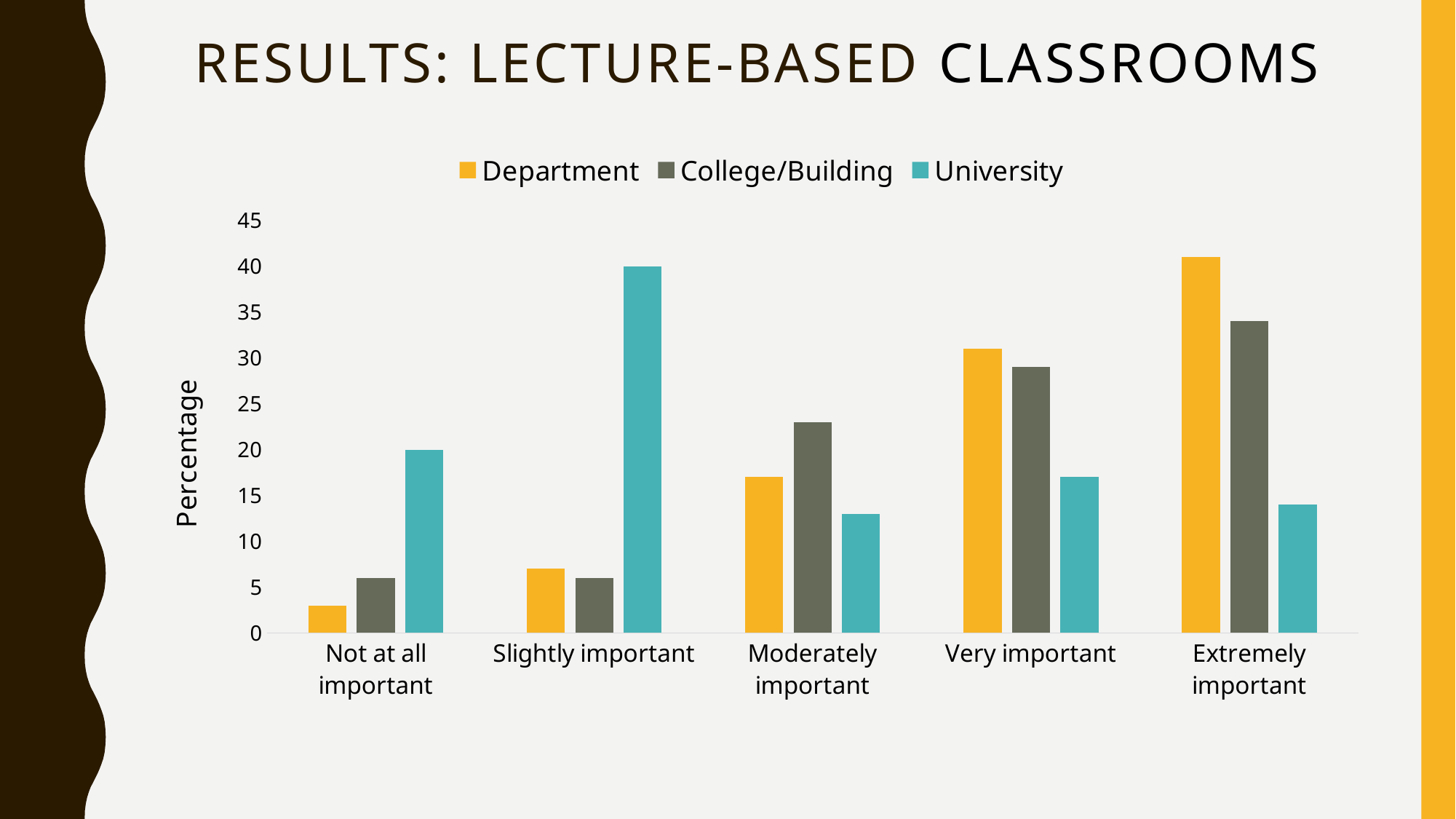
Which series has the highest value for Slightly important? University Which colour represents the University series in the legend? teal Is the University value for Slightly important greater or less than 35? greater How many series does the legend list? 3 What is the label on the vertical axis? Percentage Is the Department value for Extremely important greater or less than 40? greater Which is larger for Very important, the Department value or the University value? Department Which series has the lowest value for Not at all important? Department How many importance categories are shown on the x axis? 5 For which category is the Department value highest? Extremely important Is the College/Building value for Moderately important greater or less than 20? greater What kind of chart is shown on the slide? bar chart